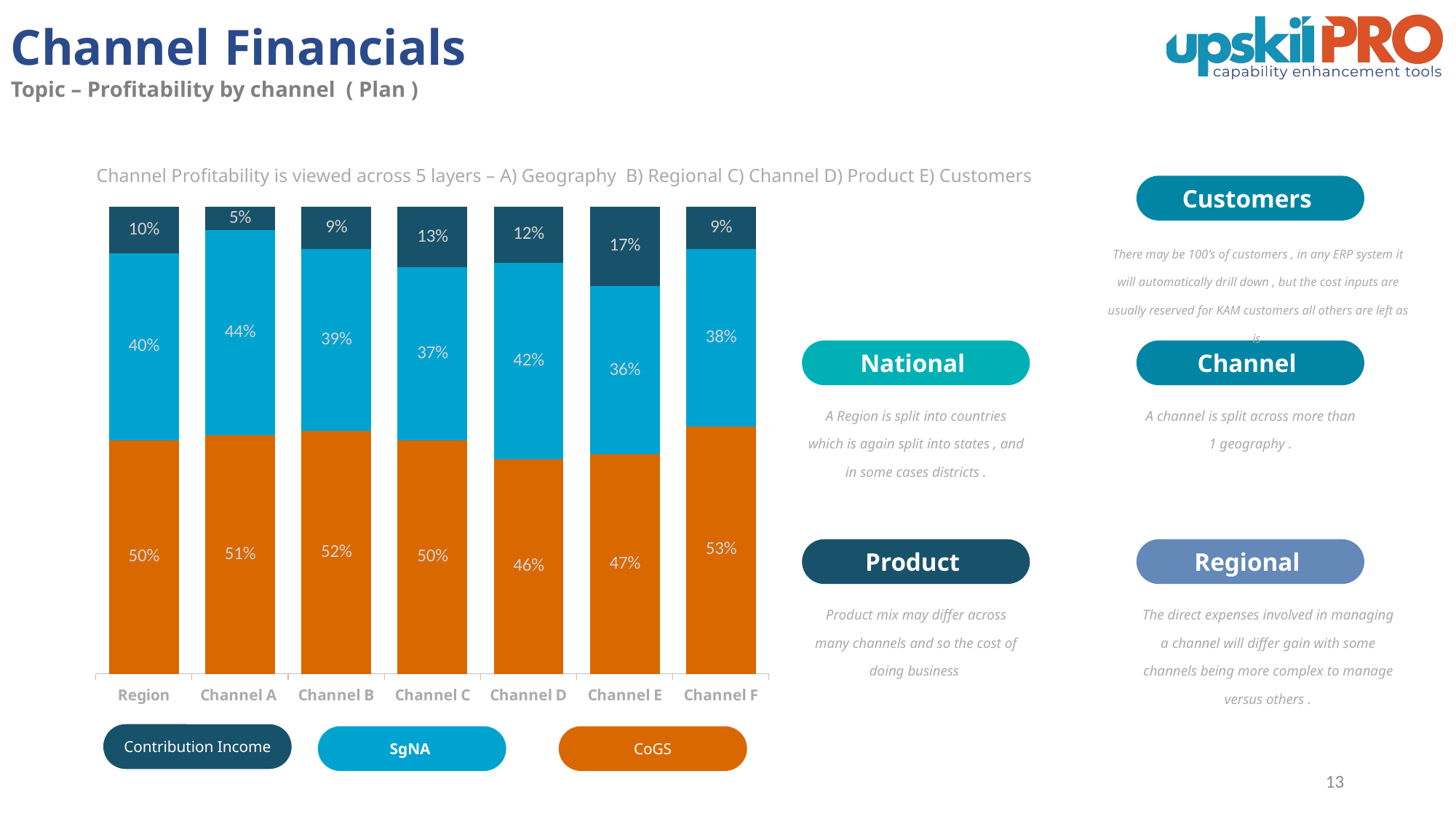
How many series does the chart's legend list? 3 What kind of chart is shown on the slide? Stacked bar chart Which category has the highest Contribution Income value? Channel E What is the Contribution Income value for Channel E? 17% Which is larger, the CoGS value for Channel B or for Channel D? Channel B Which series is shown in orange in the chart? CoGS How many categories are shown along the x axis of the chart? 7 What is the CoGS value for Channel D? 46% What is the SgNA value for Channel A? 44% Which category has the lowest Contribution Income value? Channel A What is the difference between the SgNA values for Channel A and Channel E? 8% Which category has the highest CoGS value? Channel F